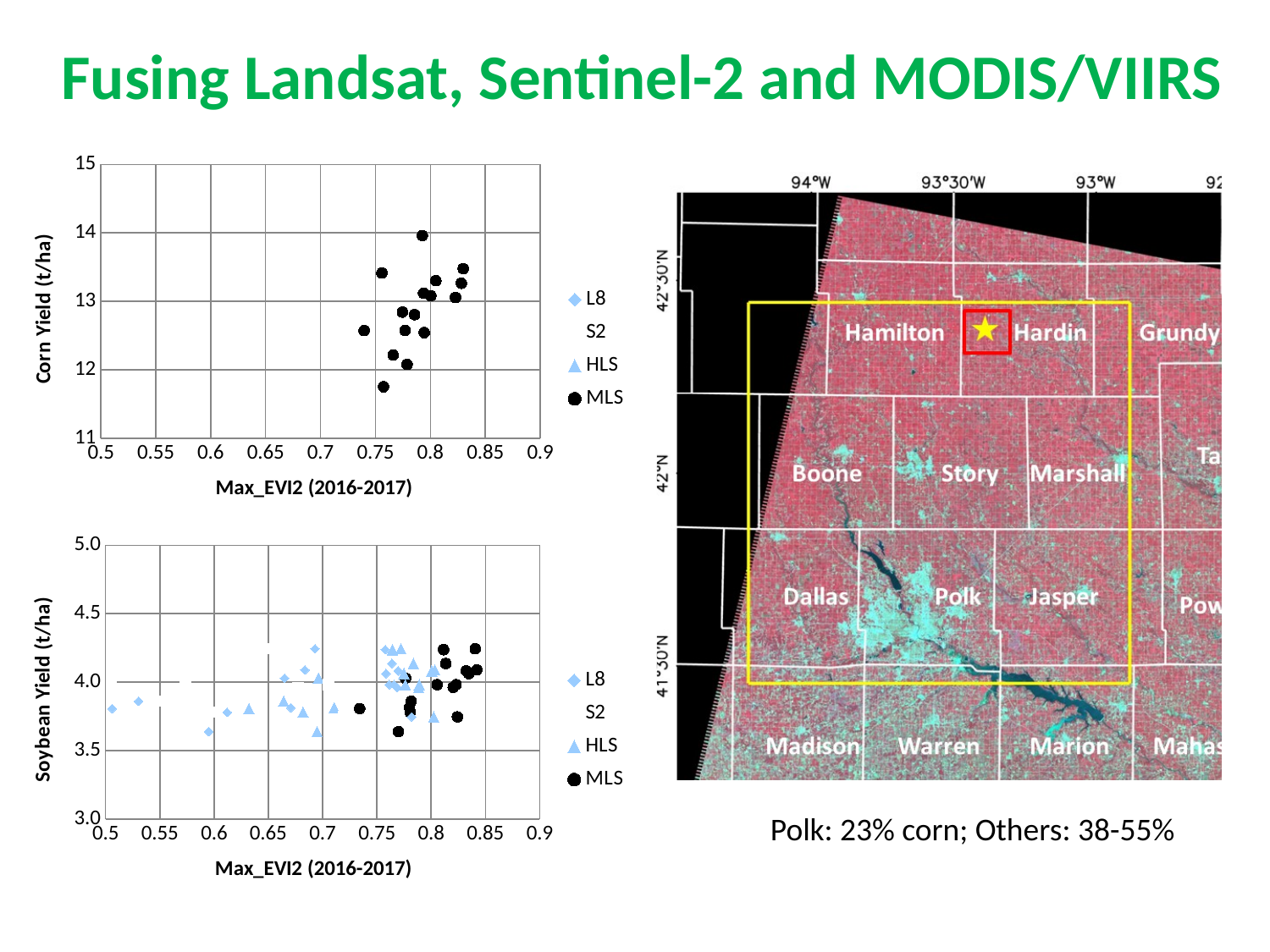
In the top-left Corn Yield chart, is the lowest plotted corn yield value greater or less than 12? less In the bottom-left Soybean Yield chart, is the lowest plotted soybean yield value greater or less than 4.0? less In the bottom-left Soybean Yield chart, what is the x-axis title? Max_EVI2 (2016-2017) What kind of chart is the top-left chart with Corn Yield on the y axis? scatter chart In the top-left Corn Yield chart, how many series does the legend list? 4 In the top-left Corn Yield chart, are the Max_EVI2 values of the MLS points greater or less than 0.7? greater In the top-left Corn Yield chart, which series is shown with black circle markers? MLS In the bottom-left Soybean Yield chart, how many series does the legend list? 4 What kind of chart is the bottom-left chart with Soybean Yield on the y axis? scatter chart